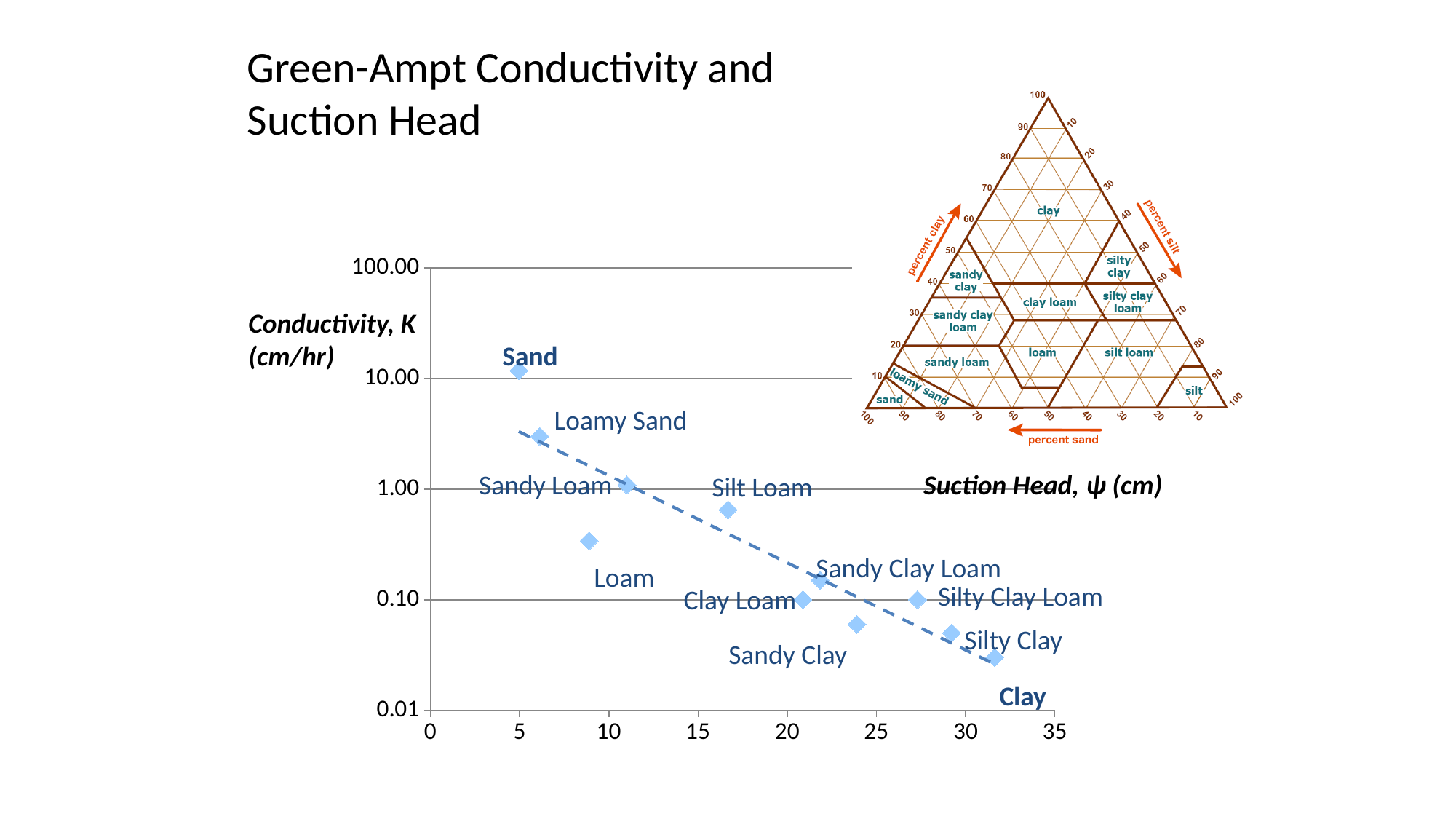
How many soil types are plotted as points in the chart? 11 Which has the higher conductivity, Silt Loam or Sandy Clay? Silt Loam Is the conductivity for Loam greater or less than 1.00 cm/hr? less Which soil type has the lowest conductivity in the chart? Clay Is the suction head for Clay greater or less than 30 cm? greater Is the suction head for Silt Loam greater or less than 15 cm? greater Which soil type has the largest suction head in the chart? Clay As suction head increases along the x axis, does conductivity generally rise or fall? fall Which soil type has the highest conductivity in the chart? Sand What kind of chart is shown on the slide? scatter chart